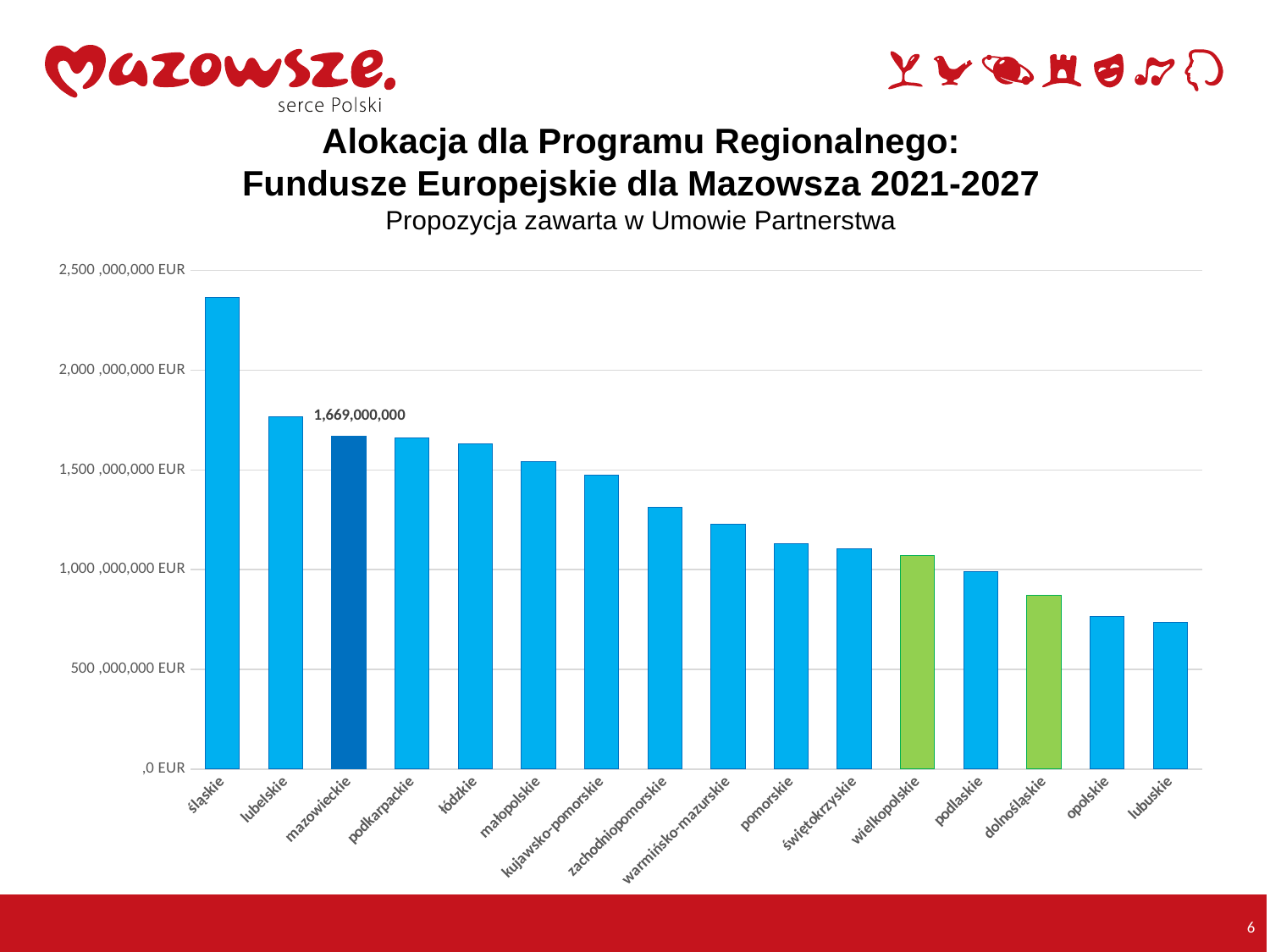
Is the value for dolnośląskie greater or less than 1,000,000,000 EUR? less Which has a larger allocation, łódzkie or pomorskie? łódzkie Is the value for zachodniopomorskie greater or less than 1,500,000,000 EUR? less Which voivodeship's bar is drawn in dark blue, unlike the other bars? mazowieckie What kind of chart is shown on the slide? bar chart Is the value for śląskie greater or less than 2,000,000,000 EUR? greater Which has a larger allocation, śląskie or lubelskie? śląskie What is the allocation value labelled for mazowieckie? 1,669,000,000 How many voivodeships (categories) are shown on the x axis of the chart? 16 Which voivodeship has the highest allocation in the chart? śląskie Do the bar values rise or fall moving from left to right along the x axis? fall